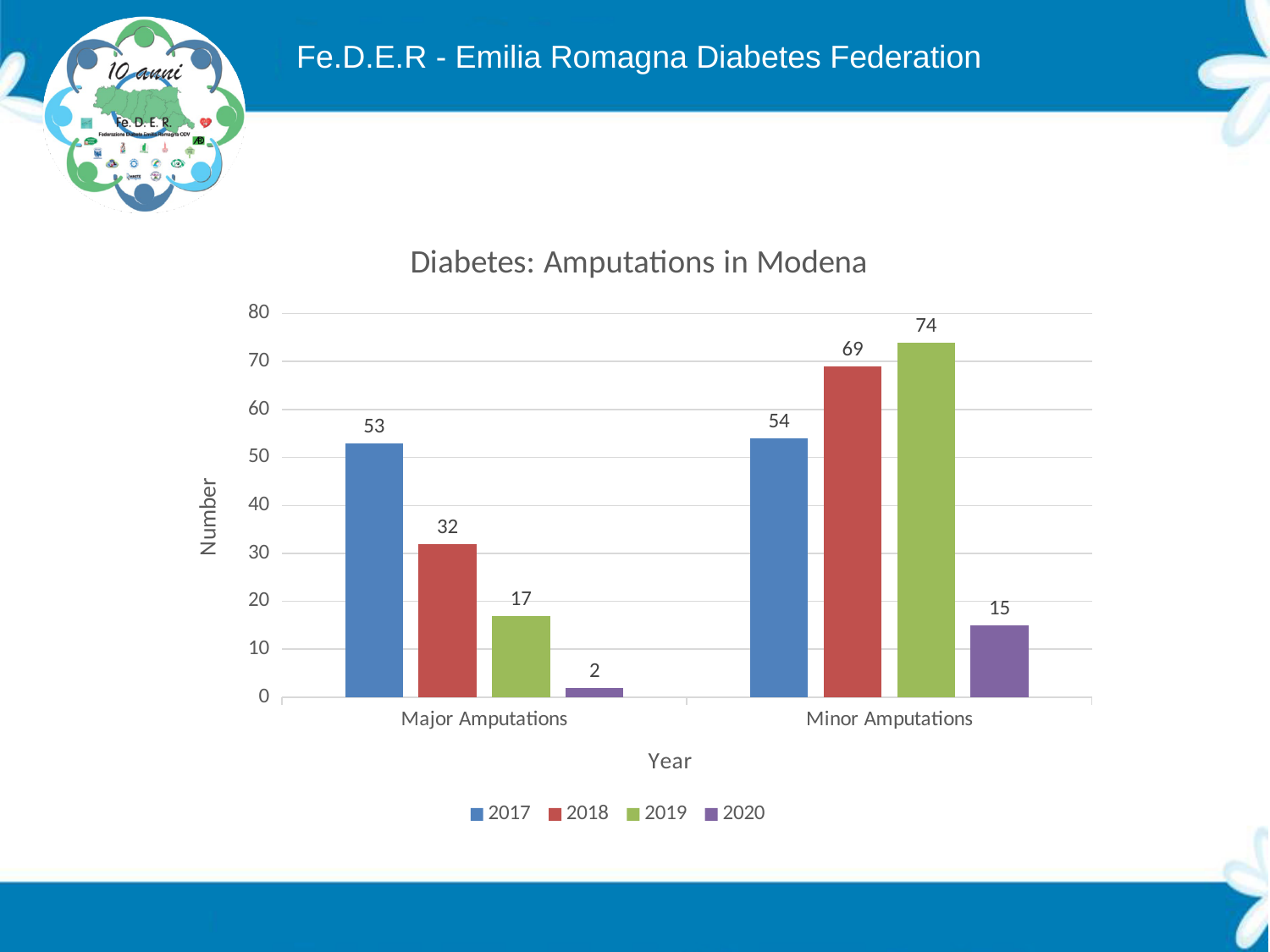
Is the value for Minor Amputations in 2020 greater or less than 20? less What is the number of Major Amputations in 2017? 53 How many series does the legend list? 4 What is the difference between Minor Amputations in 2018 and Major Amputations in 2018? 37 What kind of chart is shown on the slide? Bar chart What is the number of Minor Amputations in 2019? 74 What is the number of Major Amputations in 2020? 2 Which year has the lowest number of Major Amputations? 2020 What is the title of the chart? Diabetes: Amputations in Modena Which year has the highest number of Minor Amputations? 2019 Which is larger: Major Amputations in 2017 or Minor Amputations in 2017? Minor Amputations in 2017 How many categories are shown on the x axis? 2